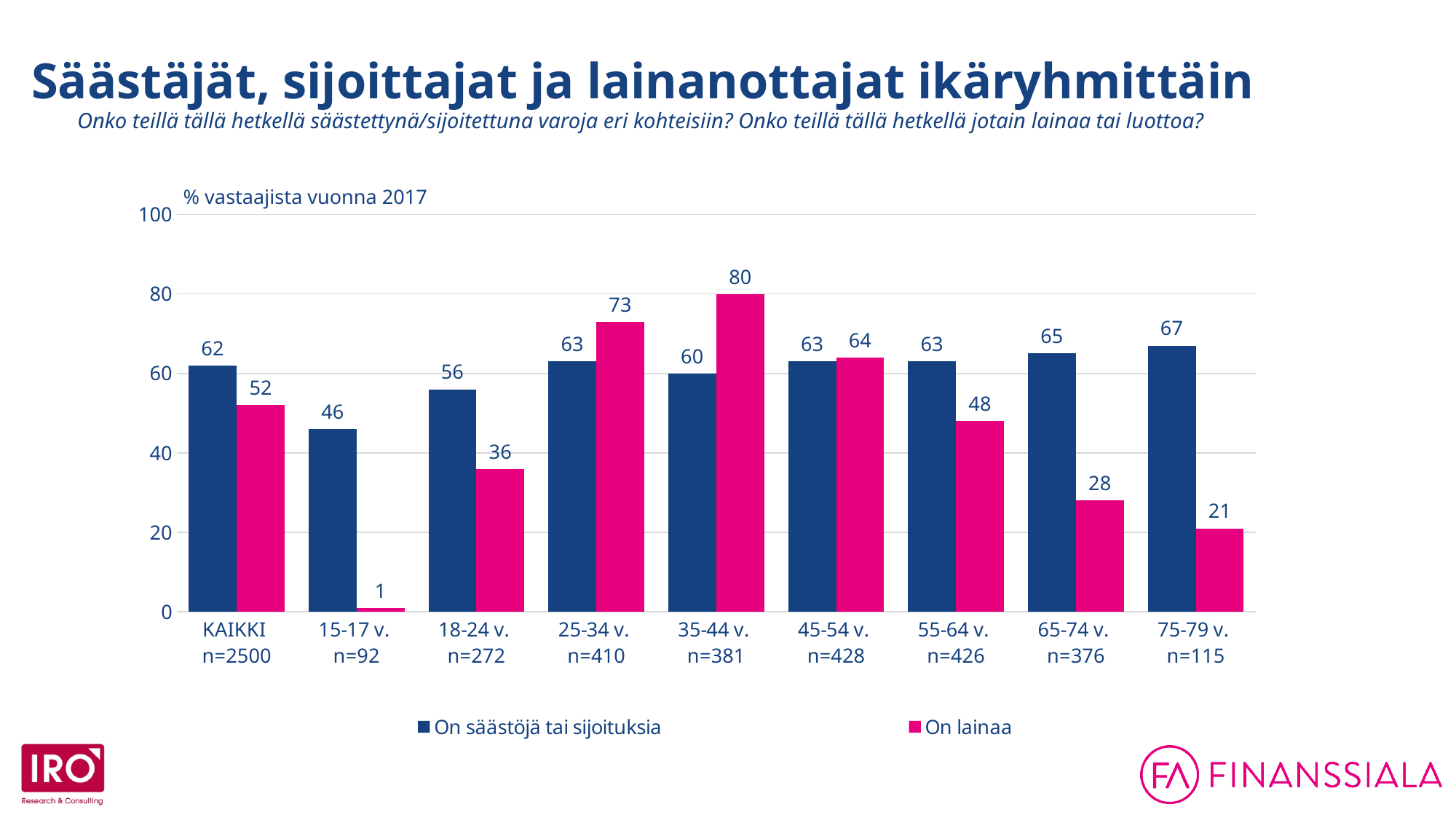
Which colour represents the 'On lainaa' series? Pink In the 25-34 v. age group, which is larger: 'On säästöjä tai sijoituksia' or 'On lainaa'? On lainaa What is the difference between 'On säästöjä tai sijoituksia' and 'On lainaa' in the 75-79 v. age group? 46 What is the value for 'On lainaa' in the 35-44 v. age group? 80 Which category has the highest value for 'On säästöjä tai sijoituksia'? 75-79 v. How many series does the legend list? 2 How many categories are shown on the x axis? 9 What is the value for 'On säästöjä tai sijoituksia' in the KAIKKI category? 62 What kind of chart is shown on the slide? Bar chart Does the value for 'On lainaa' rise or fall from the 35-44 v. group to the 75-79 v. group? Fall What is the sample size (n) for the 45-54 v. age group? n=428 Which age group has the lowest value for 'On lainaa'? 15-17 v.